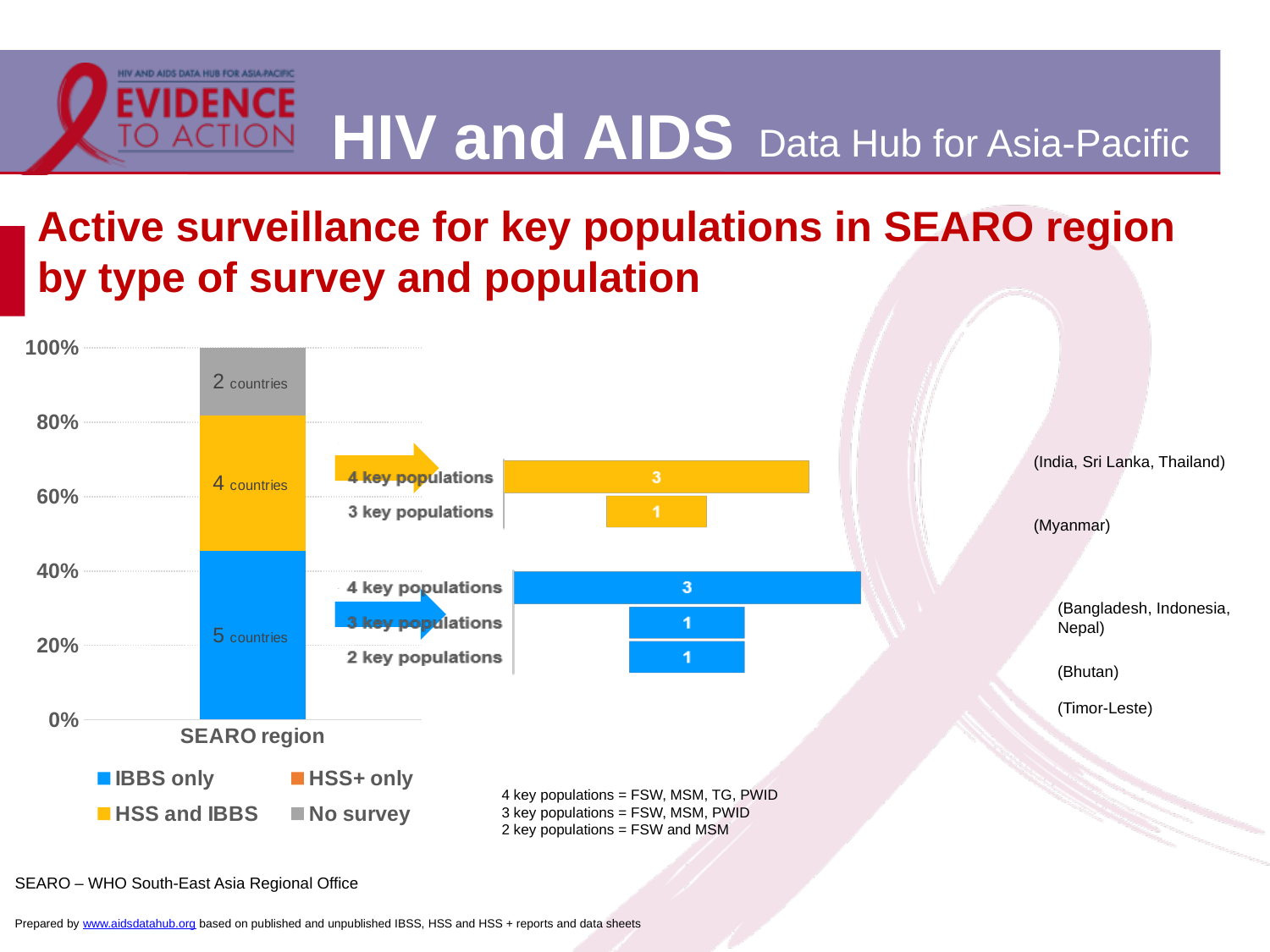
In the yellow bar chart in the middle of the slide, what is the value for "4 key populations"? 3 In the blue bar chart in the middle of the slide, what is the value for "2 key populations"? 1 In the stacked bar chart on the left, how many countries are in the "HSS and IBBS" segment? 4 countries In the stacked bar chart on the left, how many series does the legend list? 4 In the stacked bar chart on the left, how many more countries are in the "IBBS only" segment than in the "HSS and IBBS" segment? 1 In the stacked bar chart on the left, which of the three labelled segments of the SEARO region bar has the fewest countries? No survey In the stacked bar chart on the left, what is the total number of countries across all segments of the SEARO region bar? 11 In the stacked bar chart on the left, how many countries are in the "IBBS only" segment? 5 countries In the stacked bar chart on the left, which segment of the SEARO region bar has the most countries? IBBS only In the stacked bar chart on the left, how many countries are in the "No survey" segment? 2 countries What kind of chart is the chart on the left showing the SEARO region? Stacked bar chart In the blue bar chart in the middle of the slide, how many categories are shown? 3